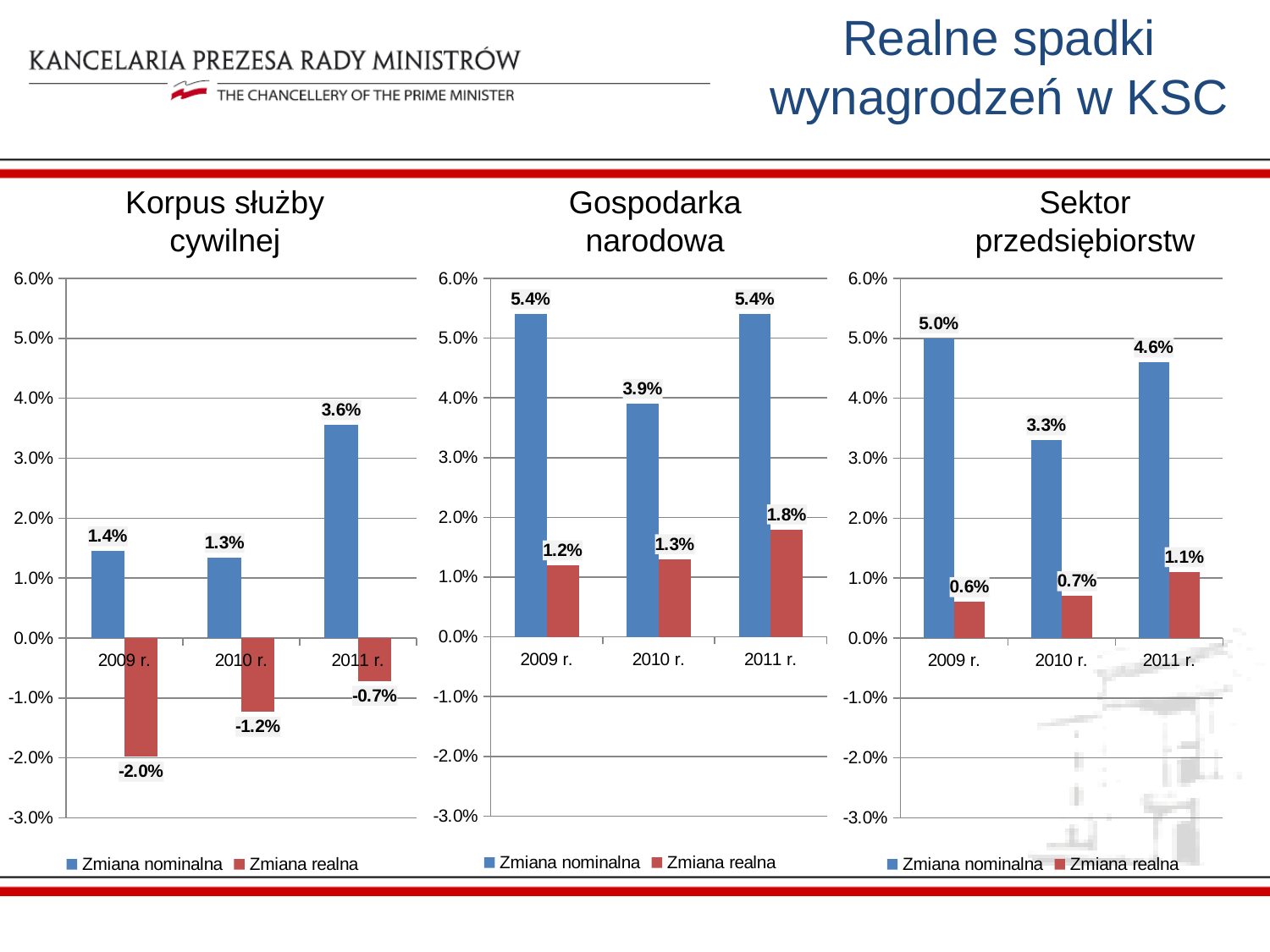
In the 'Gospodarka narodowa' chart, what is the value of Zmiana realna for 2011 r.? 1.8% In the 'Korpus służby cywilnej' chart, what is the difference between Zmiana nominalna and Zmiana realna for 2011 r.? 4.3% What kind of chart is the 'Gospodarka narodowa' chart? bar chart In the 'Korpus służby cywilnej' chart, what is the value of Zmiana realna for 2009 r.? -2.0% In the 'Gospodarka narodowa' chart, which year has the lowest Zmiana nominalna? 2010 r. How many series does the legend of the 'Korpus służby cywilnej' chart list? 2 In the 'Sektor przedsiębiorstw' chart, what is the difference between Zmiana nominalna in 2009 r. and 2011 r.? 0.4% In the 'Gospodarka narodowa' chart, is Zmiana realna for 2010 r. larger or smaller than Zmiana realna for 2011 r.? smaller In the 'Sektor przedsiębiorstw' chart, which year has the lowest Zmiana realna? 2009 r. In the 'Korpus służby cywilnej' chart, does Zmiana realna rise or fall from 2009 r. to 2011 r.? rise In the 'Sektor przedsiębiorstw' chart, what is the value of Zmiana nominalna for 2010 r.? 3.3% In the 'Korpus służby cywilnej' chart, what is the value of Zmiana nominalna for 2011 r.? 3.6%